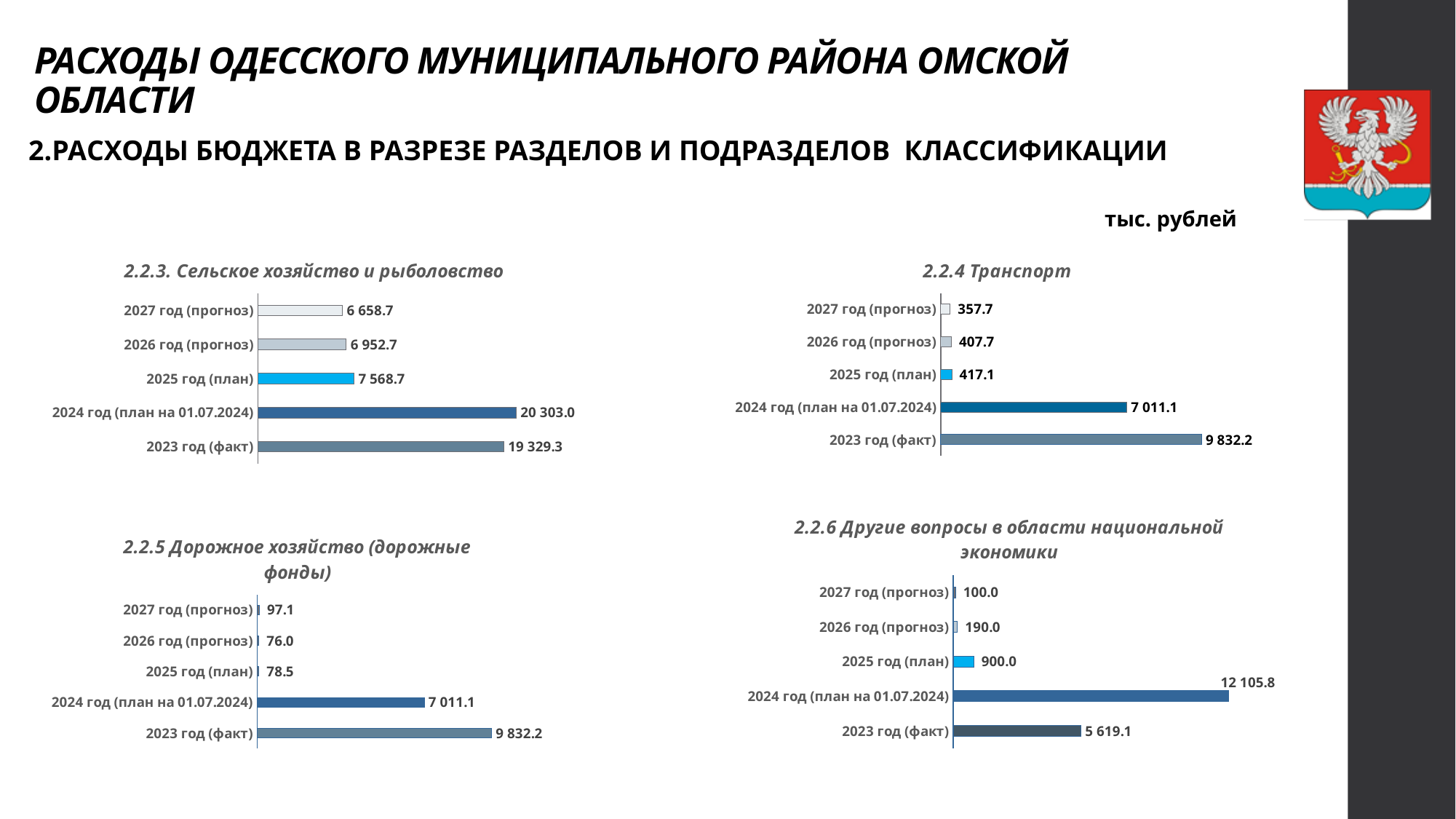
In the chart '2.2.5 Дорожное хозяйство (дорожные фонды)', what is the value for 2026 год (прогноз)? 76.0 How many categories are shown in the chart '2.2.6 Другие вопросы в области национальной экономики'? 5 What type of chart is '2.2.4 Транспорт'? Bar chart In the chart '2.2.3. Сельское хозяйство и рыболовство', what is the value for 2024 год (план на 01.07.2024)? 20 303.0 In the chart '2.2.4 Транспорт', what is the value for 2023 год (факт)? 9 832.2 In the chart '2.2.6 Другие вопросы в области национальной экономики', what is the value for 2024 год (план на 01.07.2024)? 12 105.8 In the chart '2.2.5 Дорожное хозяйство (дорожные фонды)', which category has the lowest value? 2026 год (прогноз) In the chart '2.2.3. Сельское хозяйство и рыболовство', what is the difference between the values for 2024 год (план на 01.07.2024) and 2023 год (факт)? 973.7 In the chart '2.2.4 Транспорт', which is larger: the value for 2026 год (прогноз) or 2025 год (план)? 2025 год (план) In the chart '2.2.4 Транспорт', which category has the highest value? 2023 год (факт) In the chart '2.2.6 Другие вопросы в области национальной экономики', what is the difference between the values for 2025 год (план) and 2026 год (прогноз)? 710.0 In the chart '2.2.3. Сельское хозяйство и рыболовство', which category has the lowest value? 2027 год (прогноз)